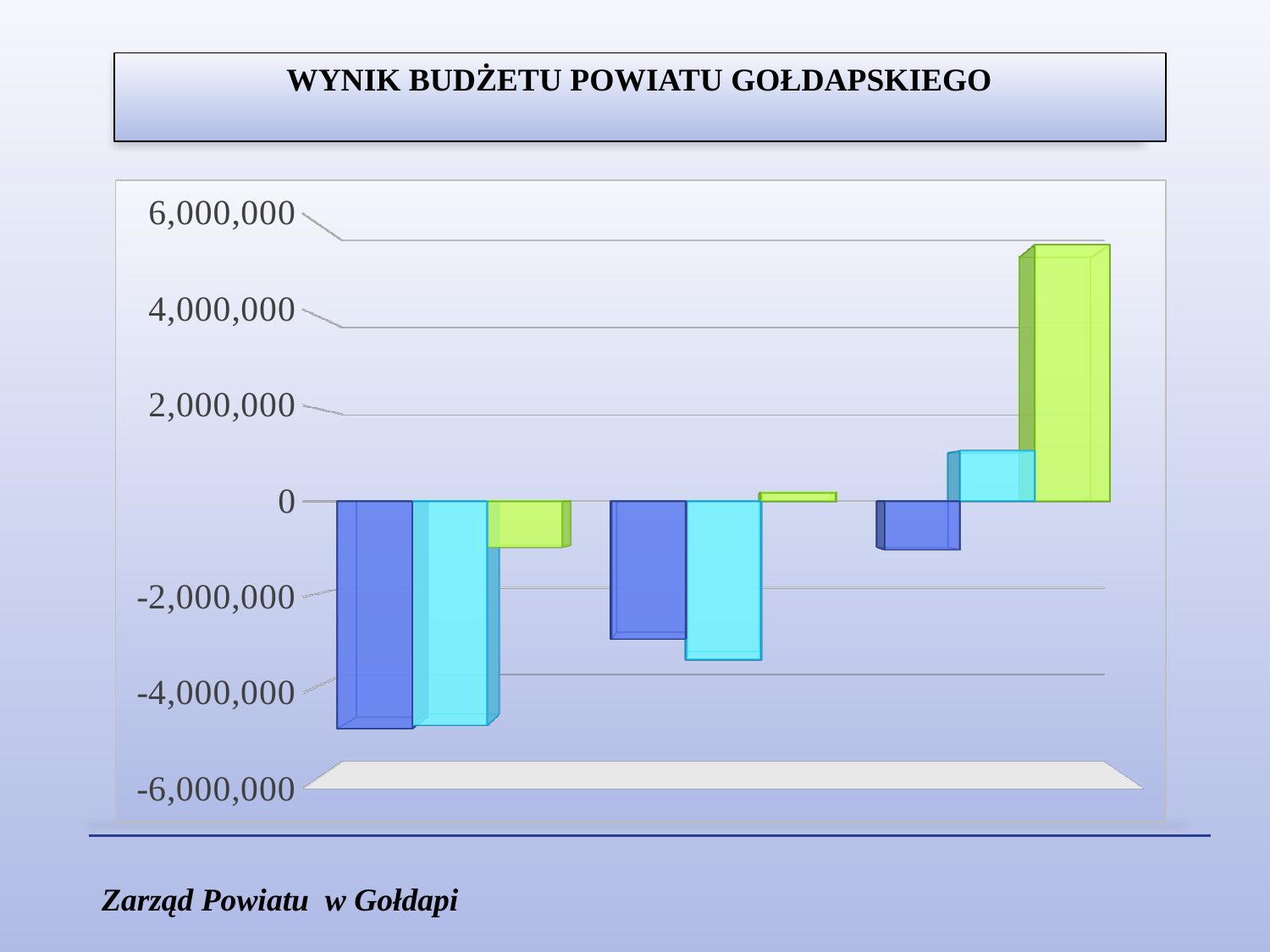
Is the value of the blue bar in the middle group greater or less than -2,000,000? less In the rightmost group, which is larger: the cyan bar or the green bar? the green bar Which bar has the highest value in the chart? the green bar in the rightmost group Is the value of the green bar in the rightmost group greater or less than 4,000,000? greater Is the value of the blue bar in the leftmost group greater or less than -4,000,000? less What is the title of the chart on the slide? WYNIK BUDŻETU POWIATU GOŁDAPSKIEGO How many different bar colours are used in the chart? 3 What kind of chart is shown on the slide? bar chart How many bars are plotted in the chart? 9 How many groups of bars does the chart show? 3